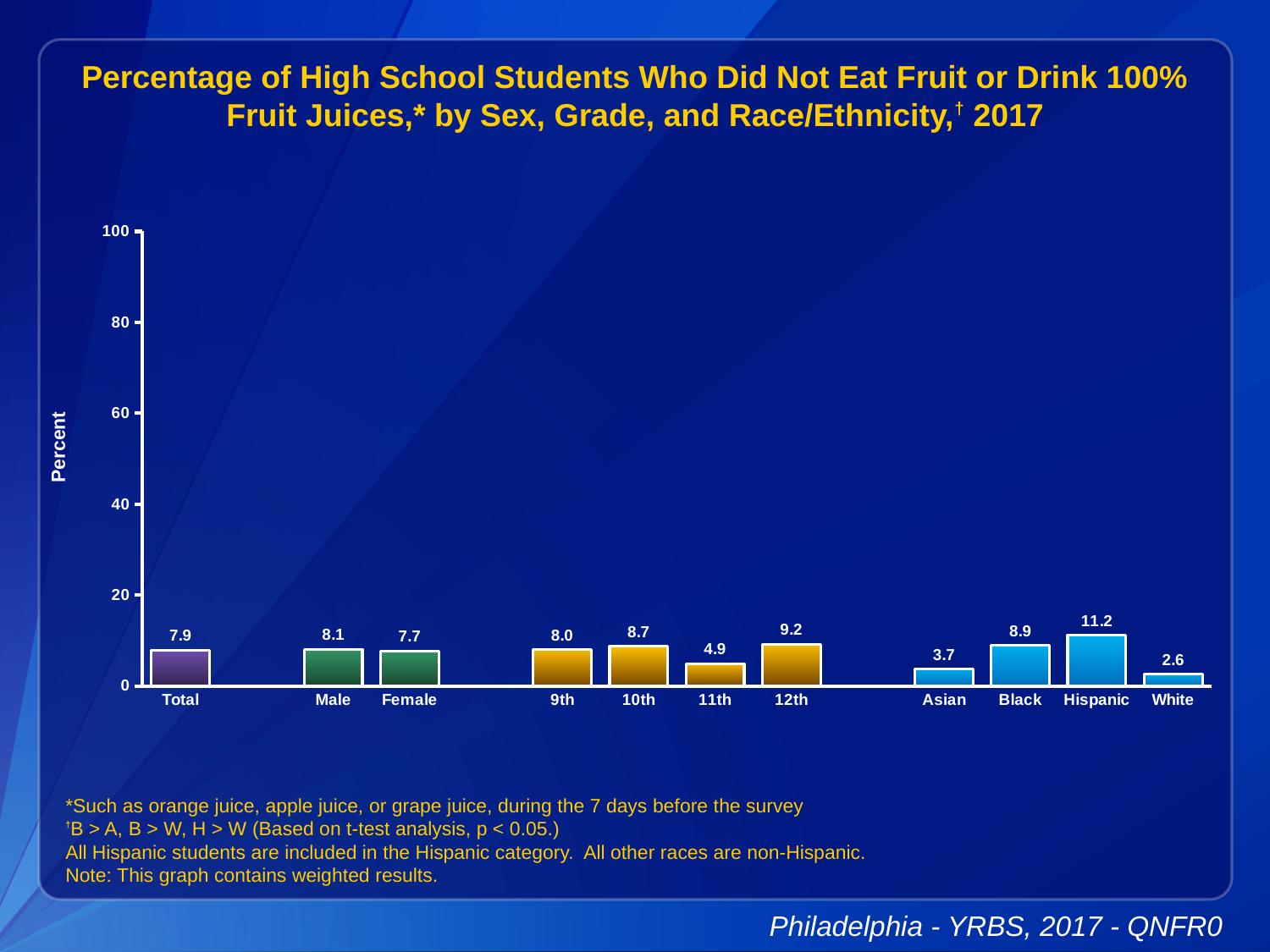
What is the value for Hispanic students? 11.2 What is the value for Total? 7.9 Which is larger, the value for 10th grade or the value for 12th grade? 12th What is the difference between the values for Hispanic and White students? 8.6 Which category has the highest value? Hispanic How many categories are shown on the x axis? 11 What is the difference between the values for Male and Female? 0.4 Which category has the lowest value? White What is the value for 11th grade students? 4.9 What is the label on the y axis? Percent What kind of chart is this? bar chart Is the value for Black students greater or less than 20? less